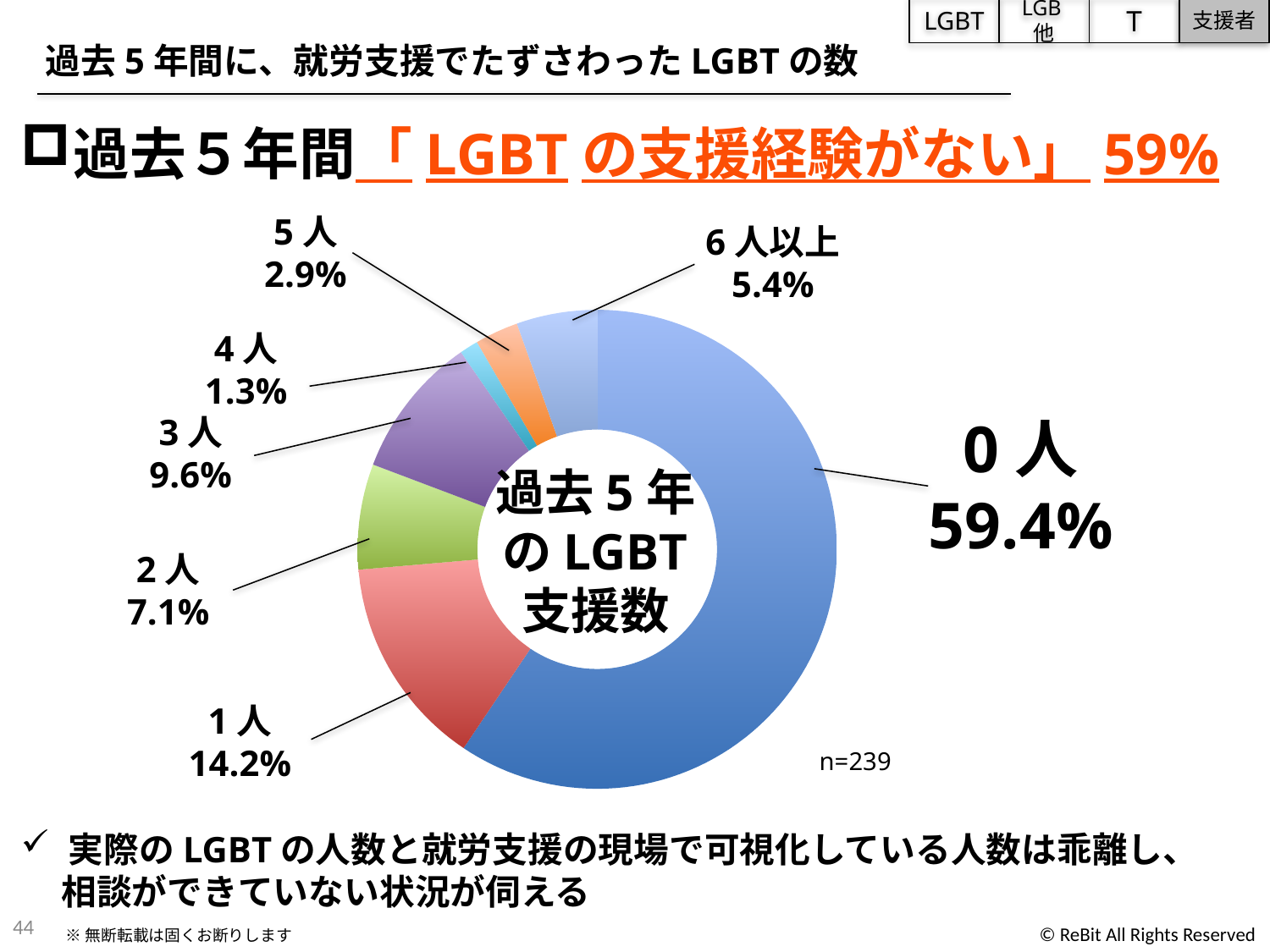
Which category has the smallest share of the donut chart? 4人 What percentage is shown for the 1人 slice? 14.2% How many categories (slices) does the donut chart have? 7 What percentage is shown for the 3人 slice? 9.6% What is the sample size (n) shown next to the chart? n=239 Which category has the largest share of the donut chart? 0人 What is the difference in percentage points between the 1人 slice and the 2人 slice? 7.1 What kind of chart is shown on the slide? Donut (pie) chart Which slice is larger, 3人 or 2人? 3人 What percentage is shown for the 6人以上 slice? 5.4% What share of the donut chart is labelled 0人? 59.4% What text is written in the centre of the donut chart? 過去5年のLGBT支援数